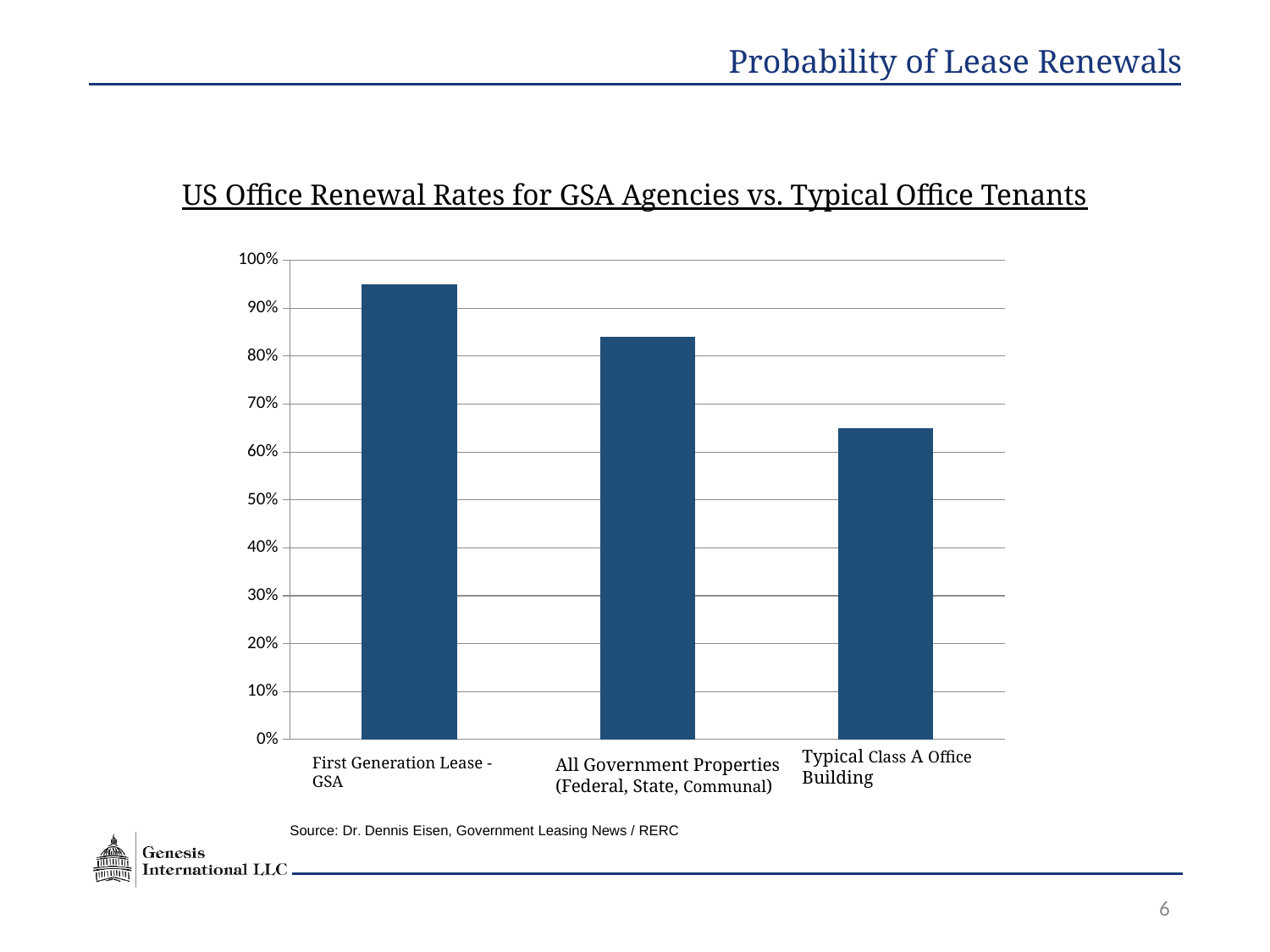
Is the value for All Government Properties (Federal, State, Communal) greater or less than 80%? greater Is the value for First Generation Lease - GSA greater or less than 90%? greater Which category has the highest renewal rate? First Generation Lease - GSA Is the value for All Government Properties (Federal, State, Communal) greater or less than 90%? less How many categories are shown on the x axis of the chart? 3 What is the maximum value shown on the y axis of the chart? 100% Which is larger, the renewal rate for All Government Properties (Federal, State, Communal) or for Typical Class A Office Building? All Government Properties (Federal, State, Communal) Do the bar values rise or fall from left to right across the x axis? Fall What type of chart is shown on the slide? Bar chart Which category has the lowest renewal rate? Typical Class A Office Building What is the title of the chart? US Office Renewal Rates for GSA Agencies vs. Typical Office Tenants